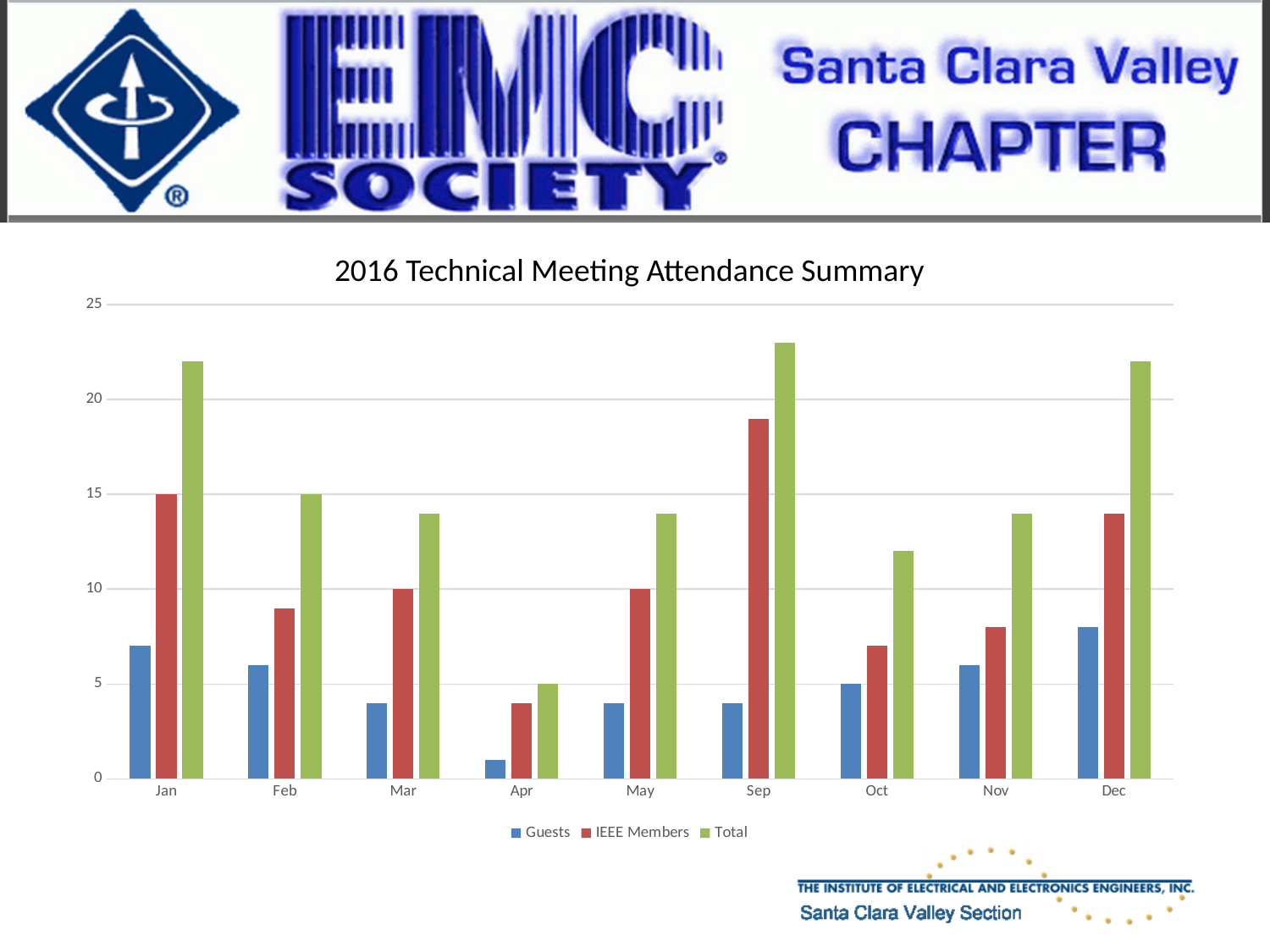
Is the Total value for Sep greater or less than 20? greater What is the title of the chart? 2016 Technical Meeting Attendance Summary What is the Total value for Feb? 15 How many series does the legend list? 3 Which month has the lowest Total? Apr What is the Total value for Apr? 5 Is the Guests value for Apr greater or less than 5? less Which month has the highest Total? Sep What is the IEEE Members value for Jan? 15 Which is larger, the IEEE Members value for Sep or the IEEE Members value for Oct? Sep How many months are shown on the x axis? 9 What type of chart is shown on the slide? bar chart